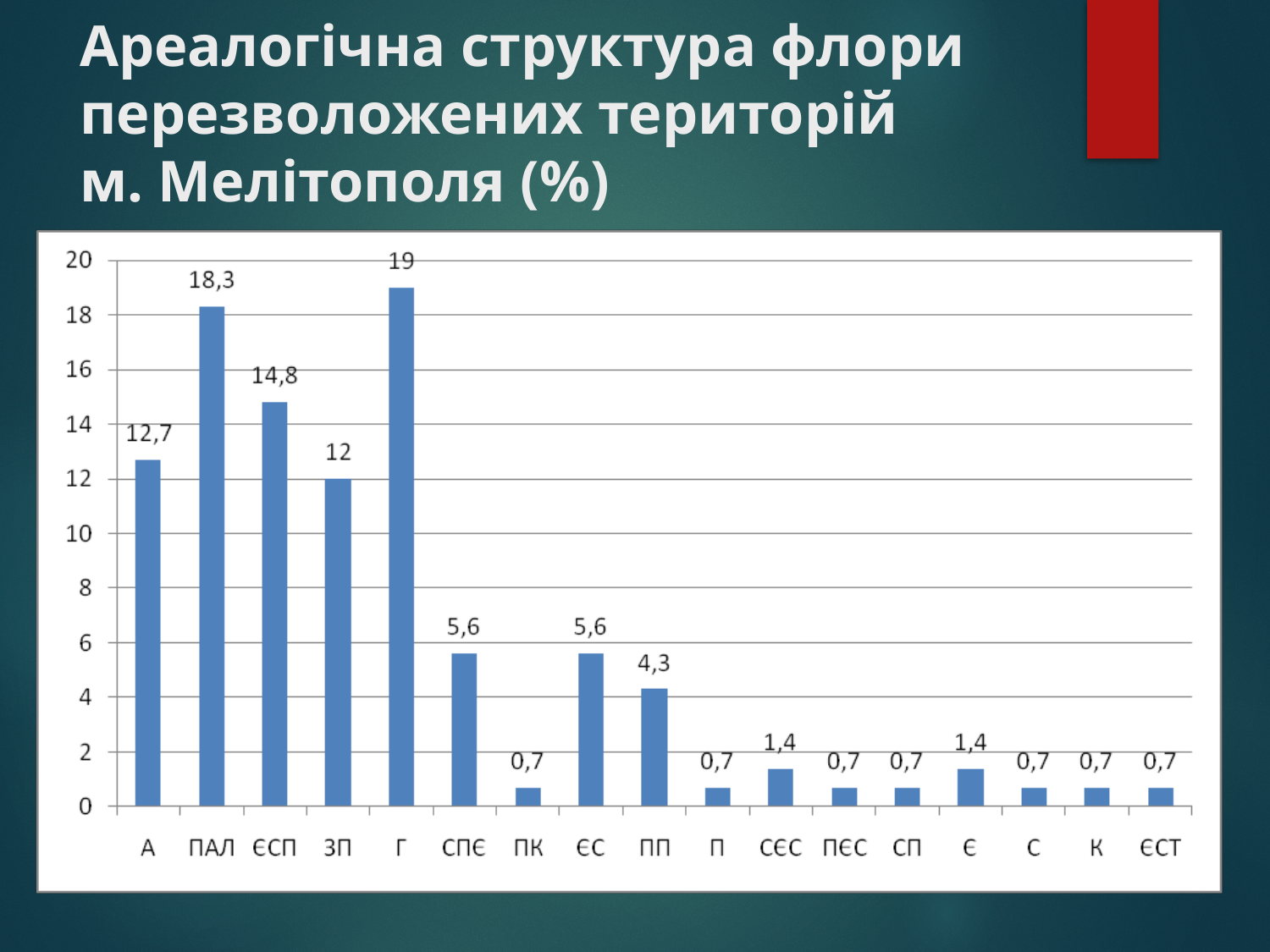
What type of chart is shown on the slide? bar chart What is the value for ПАЛ? 18,3 What is the value for ПП? 4,3 Which is larger, the value for А or the value for ЗП? А Which category has the highest value? Г What is the difference between the values for Г and ПАЛ? 0,7 What is the value for СЄС? 1,4 What is the value for ЄСП? 14,8 How many categories are shown on the x axis? 17 What is the difference between the values for ПАЛ and ЄСП? 3,5 Which is larger, the value for СПЄ or the value for ПП? СПЄ What is the title of the slide? Ареалогічна структура флори перезволожених територій м. Мелітополя (%)